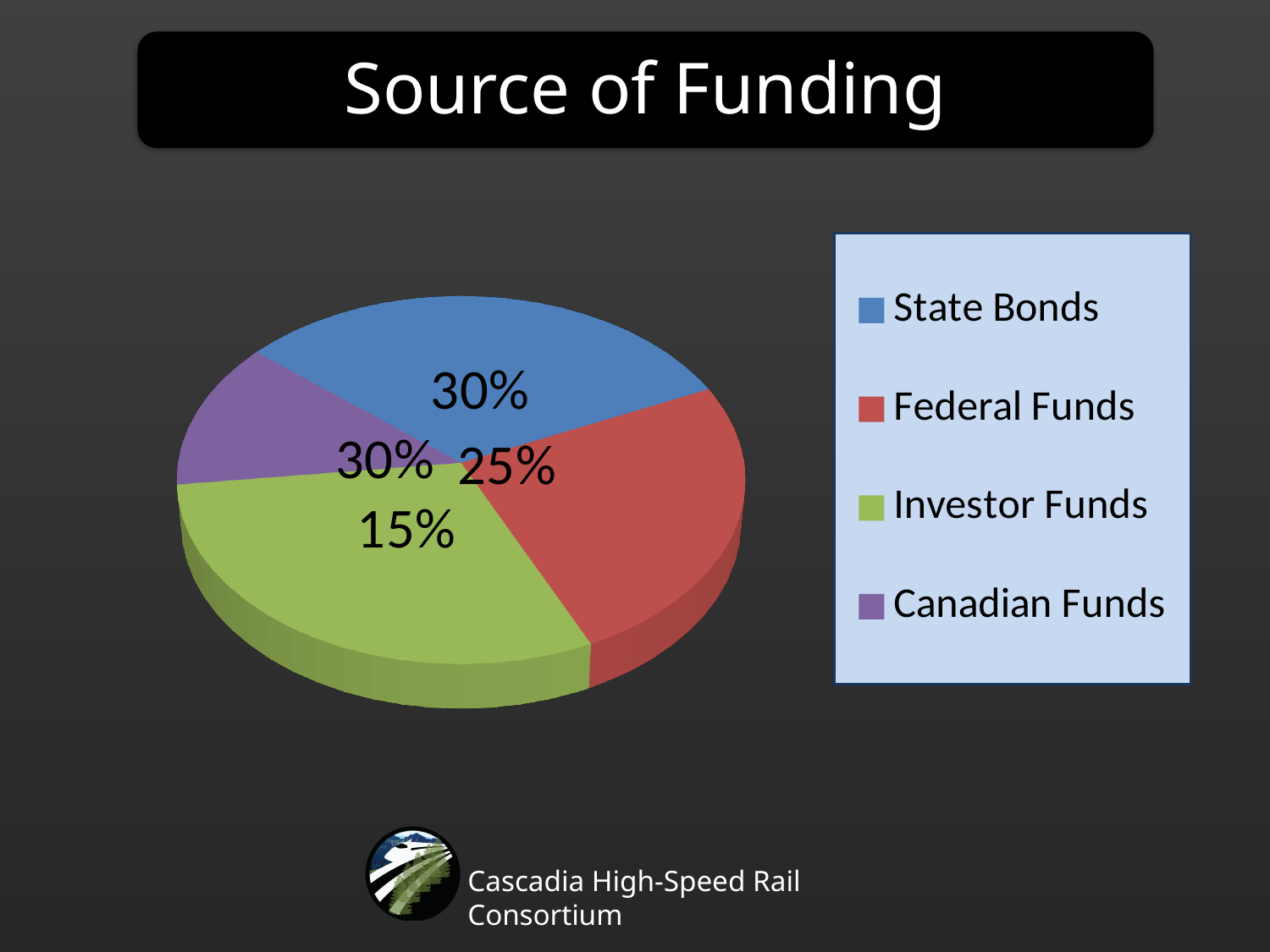
What share of funding comes from Canadian Funds? 15% Which is larger, the share for Federal Funds or the share for Canadian Funds? Federal Funds What is the difference between the State Bonds share and the Federal Funds share? 5% What share of funding comes from Federal Funds? 25% What type of chart is shown on the slide? Pie chart What share of funding comes from Investor Funds? 30% What is the title of the chart? Source of Funding Which colour represents Investor Funds in the chart? Green Which funding source has the smallest share? Canadian Funds How many funding sources does the legend list? 4 What is the difference between the Federal Funds share and the Canadian Funds share? 10%